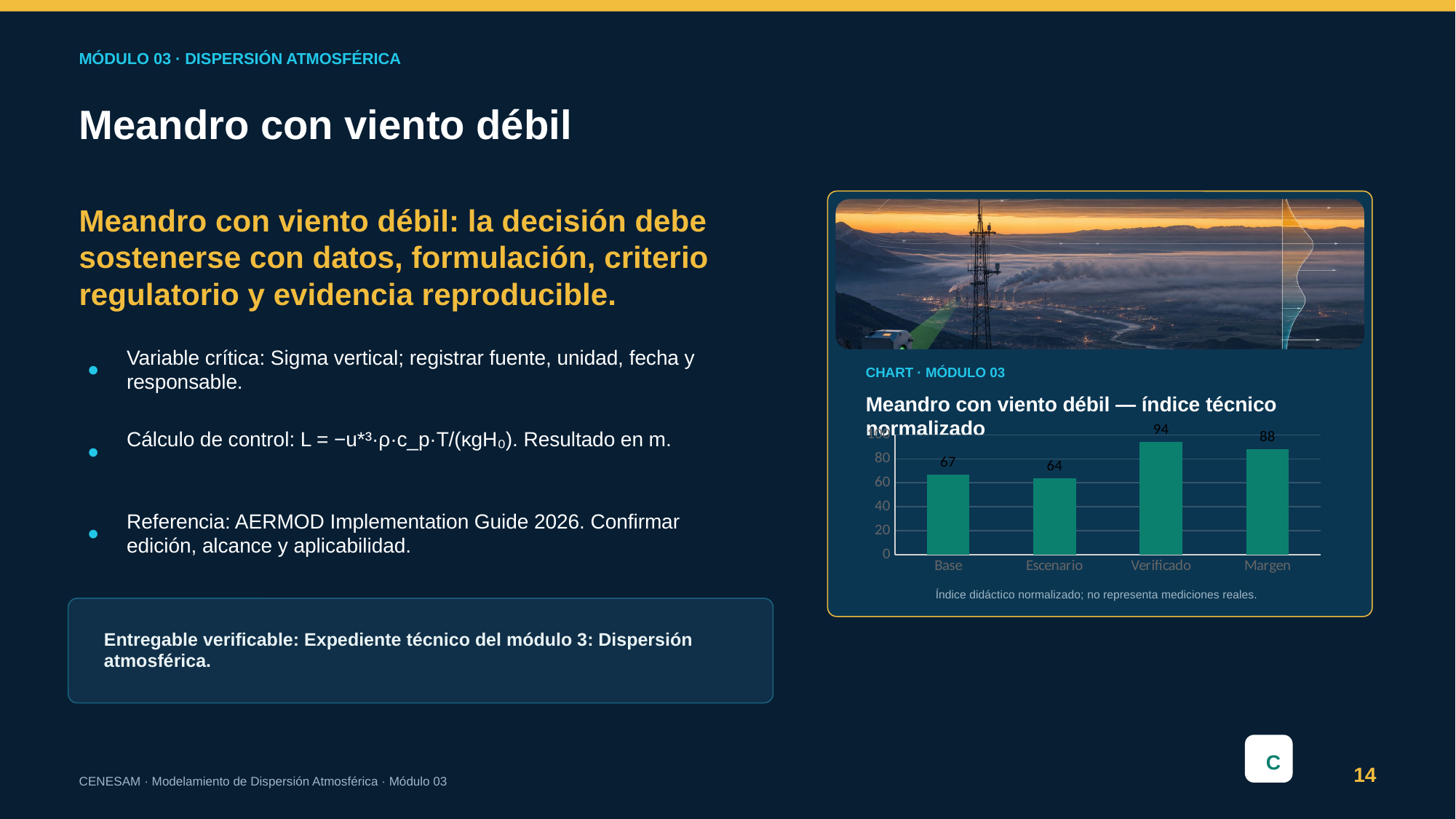
Which category has the lowest value? Escenario What is the value for Escenario? 64 What is the title of the chart? Meandro con viento débil — índice técnico normalizado Is the value for Margen greater or less than 80? greater Which is larger, the value for Base or the value for Escenario? Base What is the value for Base? 67 Which category has the highest value? Verificado How many categories are shown on the x axis? 4 What is the value for Margen? 88 What kind of chart is shown? bar chart What is the value for Verificado? 94 What is the difference between the values for Verificado and Margen? 6